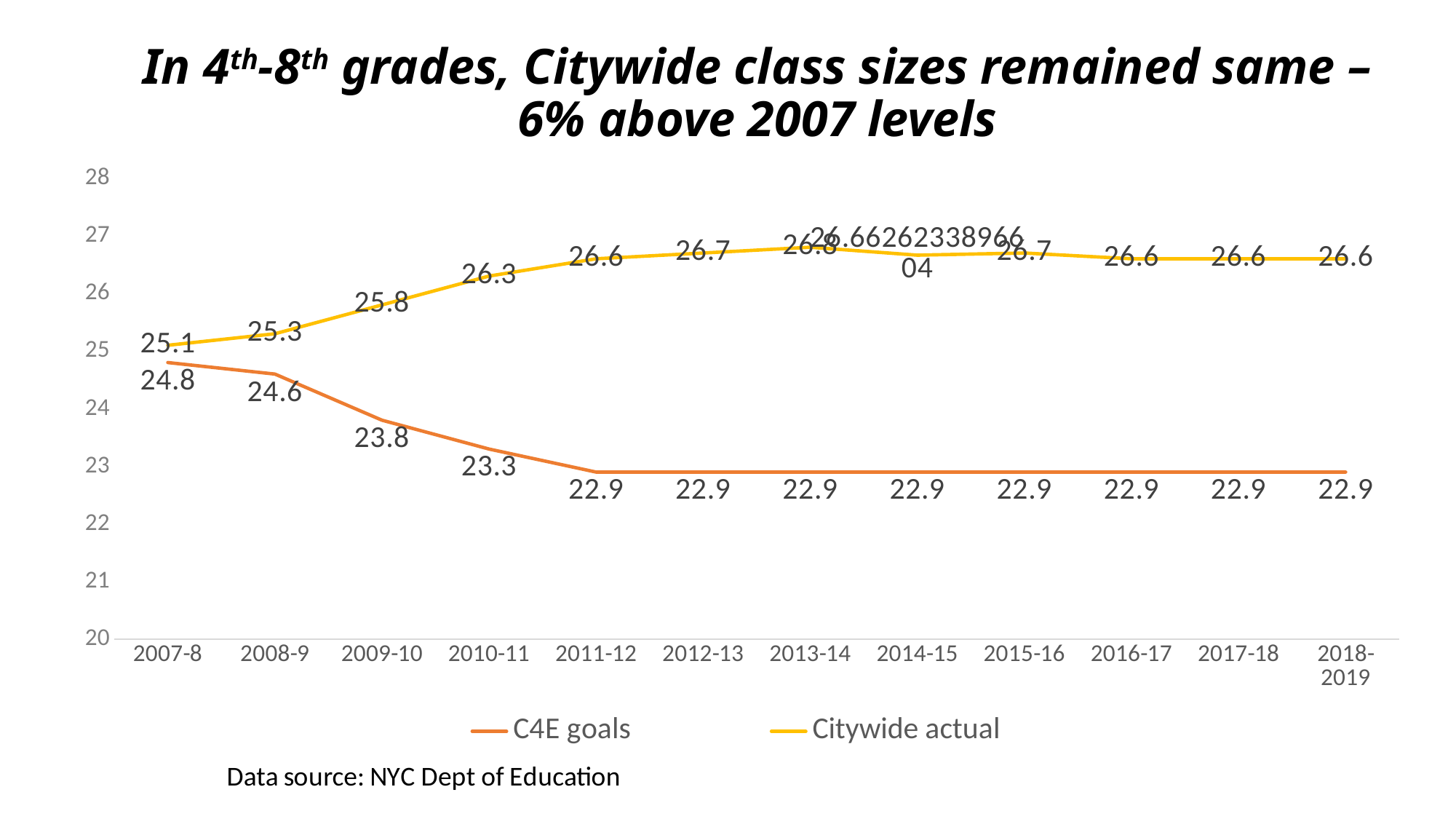
Is the C4E goals value for 2015-16 greater or less than 23? less In which school year is the Citywide actual value lowest? 2007-8 How many school years are plotted along the x axis? 12 What kind of chart is shown on the slide? line chart What is the Citywide actual class size for 2007-8? 25.1 What is the Citywide actual value for 2018-2019? 26.6 How many series does the legend list? 2 In 2009-10, which series has the larger value, C4E goals or Citywide actual? Citywide actual What is the difference between the Citywide actual value and the C4E goals value in 2012-13? 3.8 What is the difference between the Citywide actual value and the C4E goals value in 2007-8? 0.3 What is the C4E goals value for 2010-11? 23.3 Do the C4E goals values rise or fall from 2007-8 to 2011-12? fall